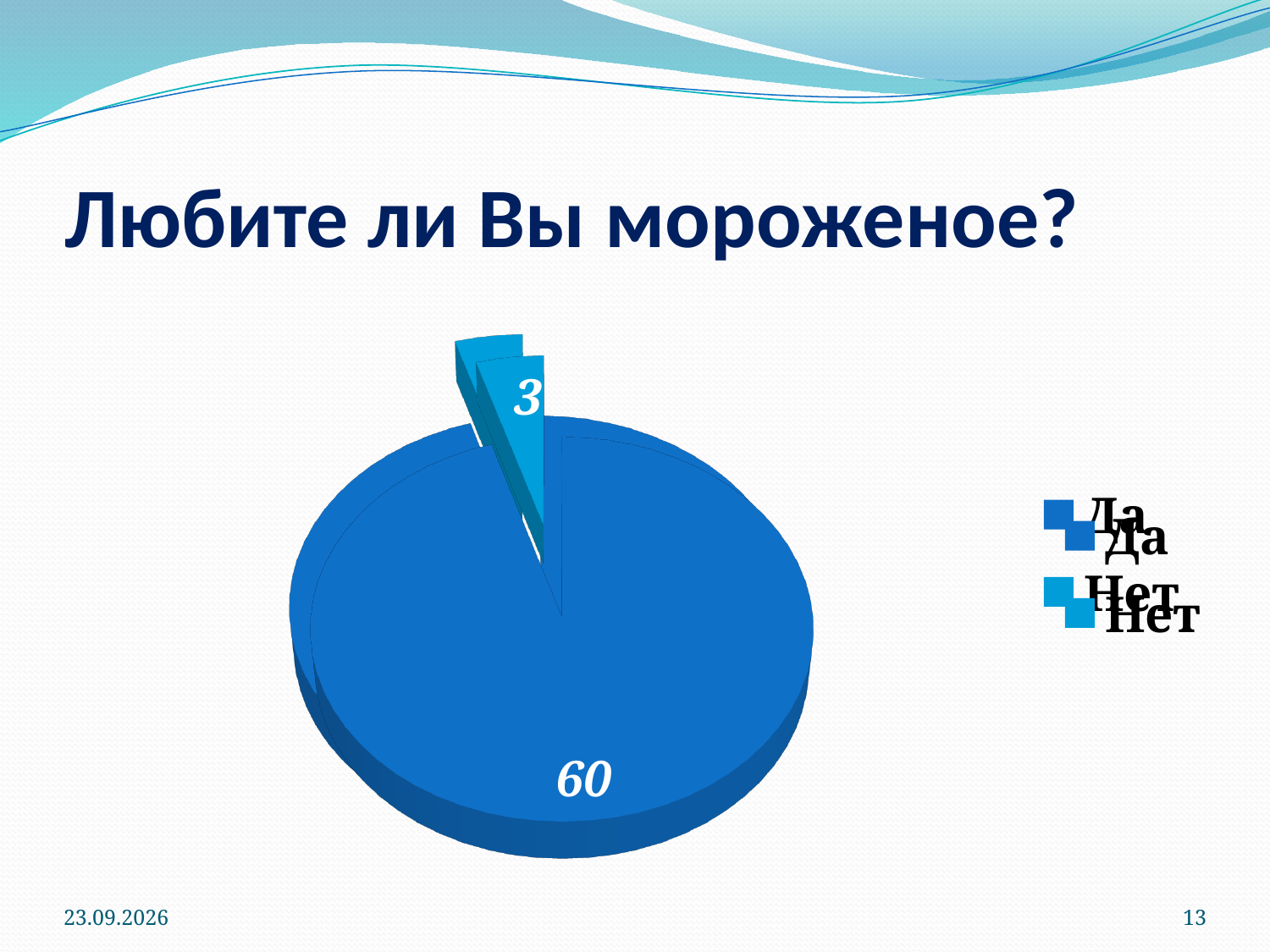
How many slices does the pie chart have? 2 What is the value shown for the "Да" slice? 60 What is the difference between the values for "Да" and "Нет"? 57 What is the title of the slide containing the chart? Любите ли Вы мороженое? Which slice of the pie is the smallest? Нет What is the value shown for the "Нет" slice? 3 Which is larger, the value for "Да" or the value for "Нет"? Да Which legend entry is listed first? Да Which slice of the pie is the largest? Да What kind of chart is shown on the slide? pie chart What is the total of all the values shown on the pie chart? 63